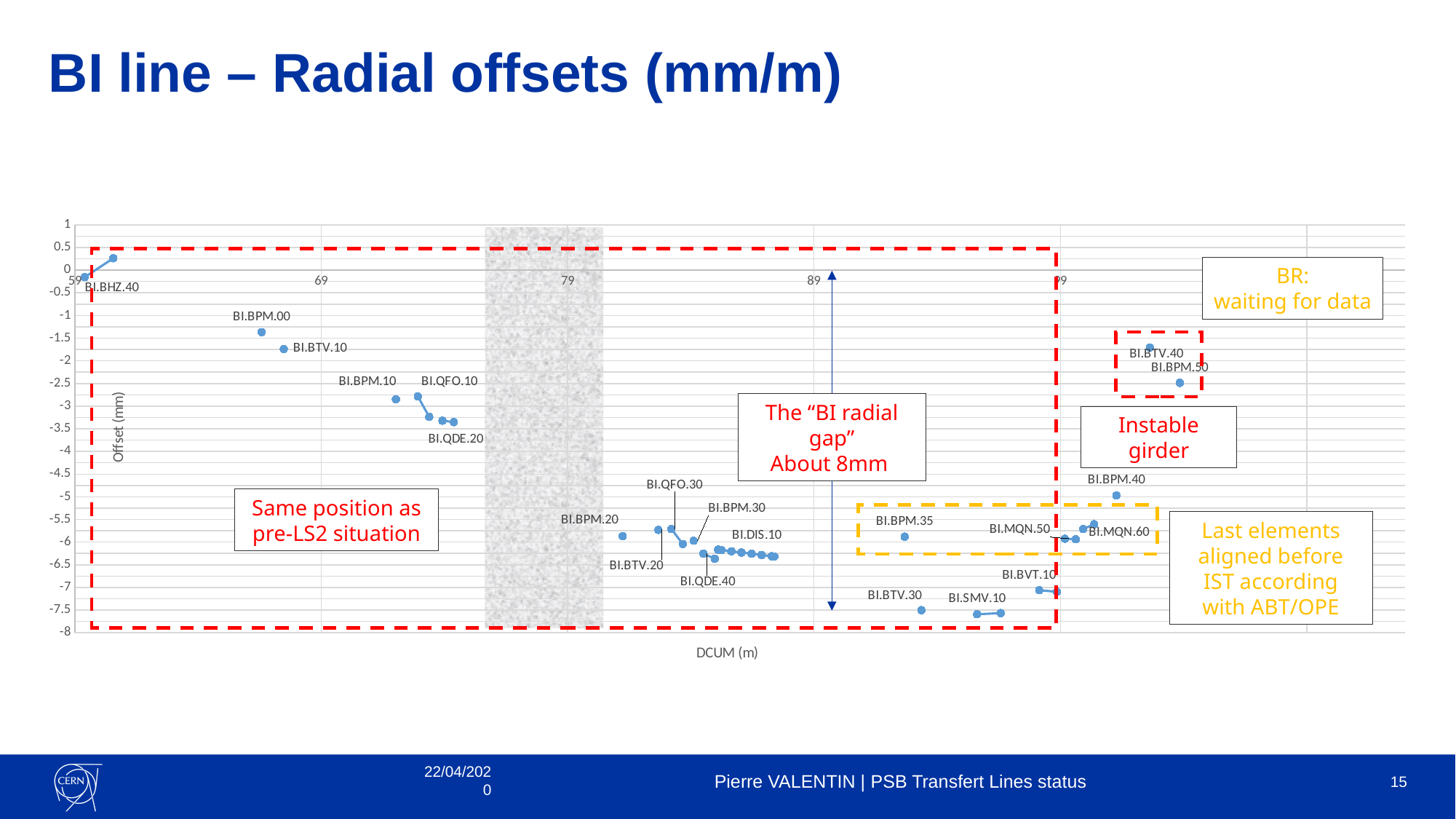
Is the offset for BI.QDE.20 greater or less than -3? less Which has the larger offset, BI.BPM.00 or BI.BPM.20? BI.BPM.00 Which labelled element has the highest offset on the chart? BI.BHZ.40 Is the offset for BI.BPM.40 greater or less than -4? less Is the offset for BI.BPM.00 greater or less than -1? less What is the title of the x axis of the chart? DCUM (m) What kind of chart is shown on the slide? scatter chart Do the offsets rise or fall along the x axis from BI.BHZ.40 to BI.QDE.20? fall What is the title of the y axis of the chart? Offset (mm) Which has the larger offset, BI.BTV.40 or BI.BPM.50? BI.BTV.40